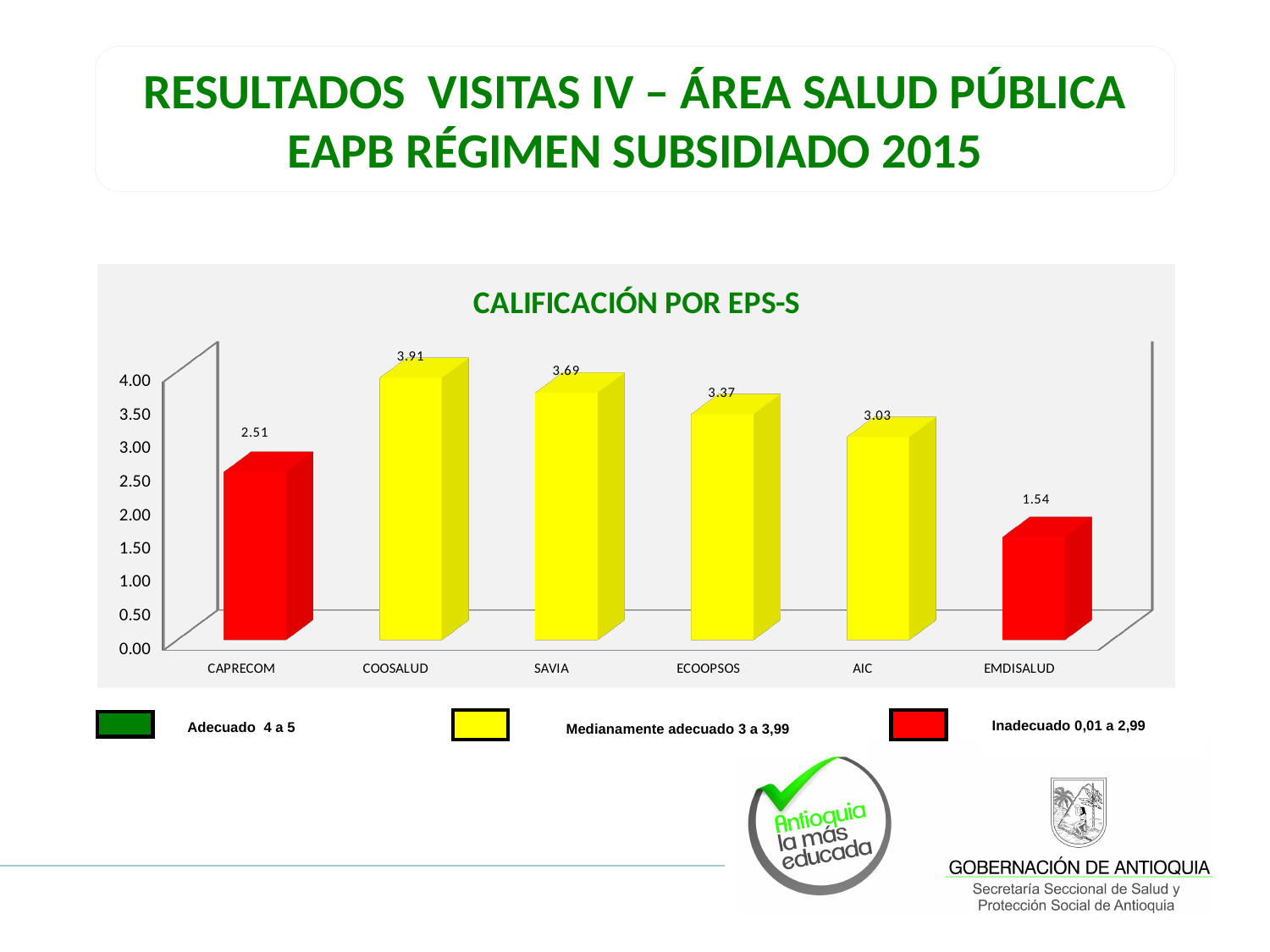
Is the value for CAPRECOM greater or less than 3.00? less What is the title of the chart? CALIFICACIÓN POR EPS-S What kind of chart is shown on the slide? bar chart How many EPS-S categories are shown on the chart? 6 What is the difference between the values for COOSALUD and CAPRECOM? 1.40 What colour are the bars for CAPRECOM and EMDISALUD? red What is the value for COOSALUD? 3.91 Which EPS-S has the highest calificación? COOSALUD Which is larger, the value for SAVIA or the value for AIC? SAVIA What is the value for ECOOPSOS? 3.37 What is the value for EMDISALUD? 1.54 Which EPS-S has the lowest calificación? EMDISALUD